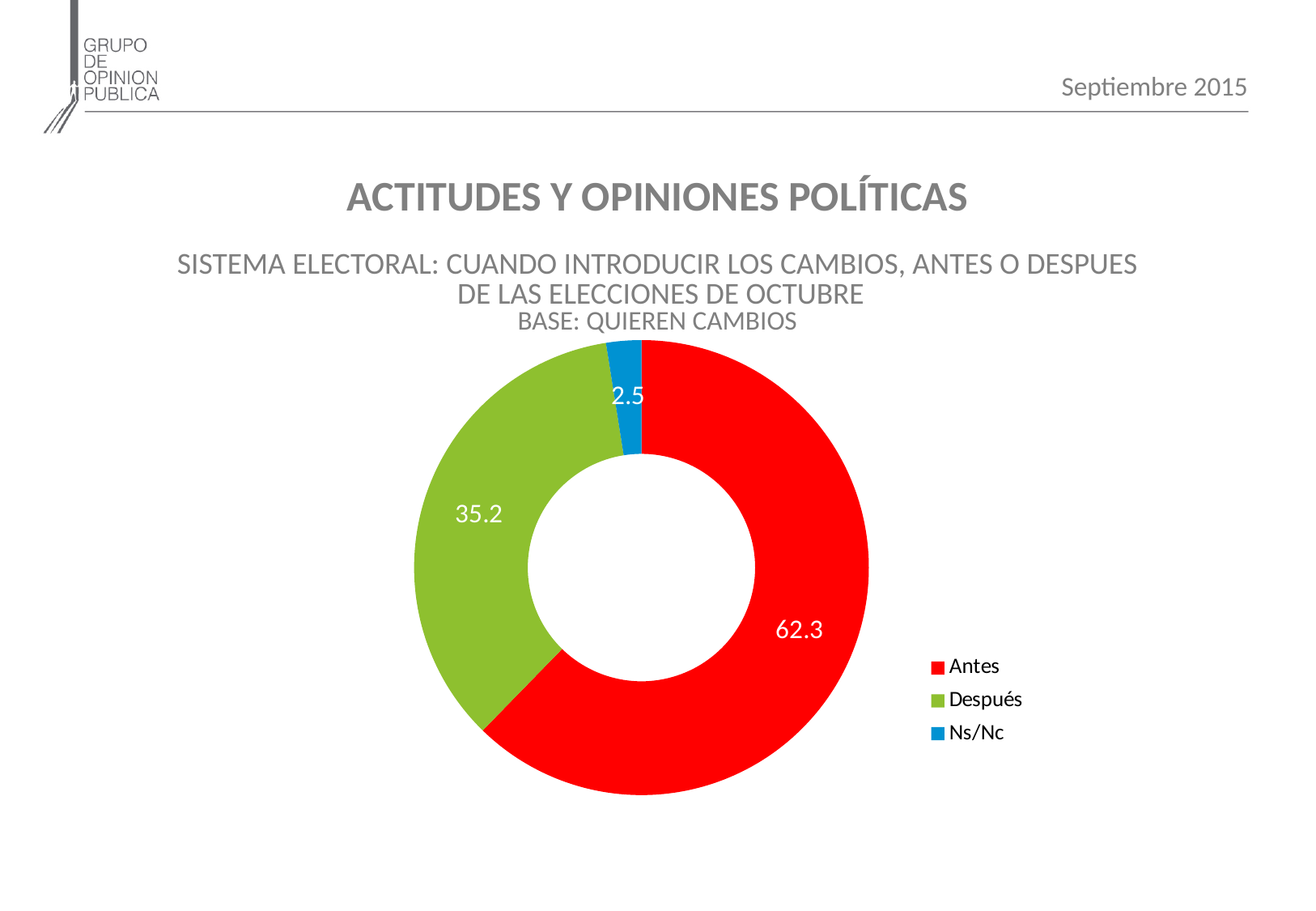
What is the total of the three values shown on the chart? 100 What colour is the slice for Después? Green How many categories does the chart show? 3 What is the value for Antes? 62.3 Which category has the smallest share of the chart? Ns/Nc What is the base stated for the chart? Quieren cambios What is the value for Después? 35.2 Which category has the largest share of the chart? Antes Which is larger, the value for Después or the value for Ns/Nc? Después What kind of chart is shown on the slide? Doughnut chart What is the difference between the values for Antes and Después? 27.1 What is the value for Ns/Nc? 2.5